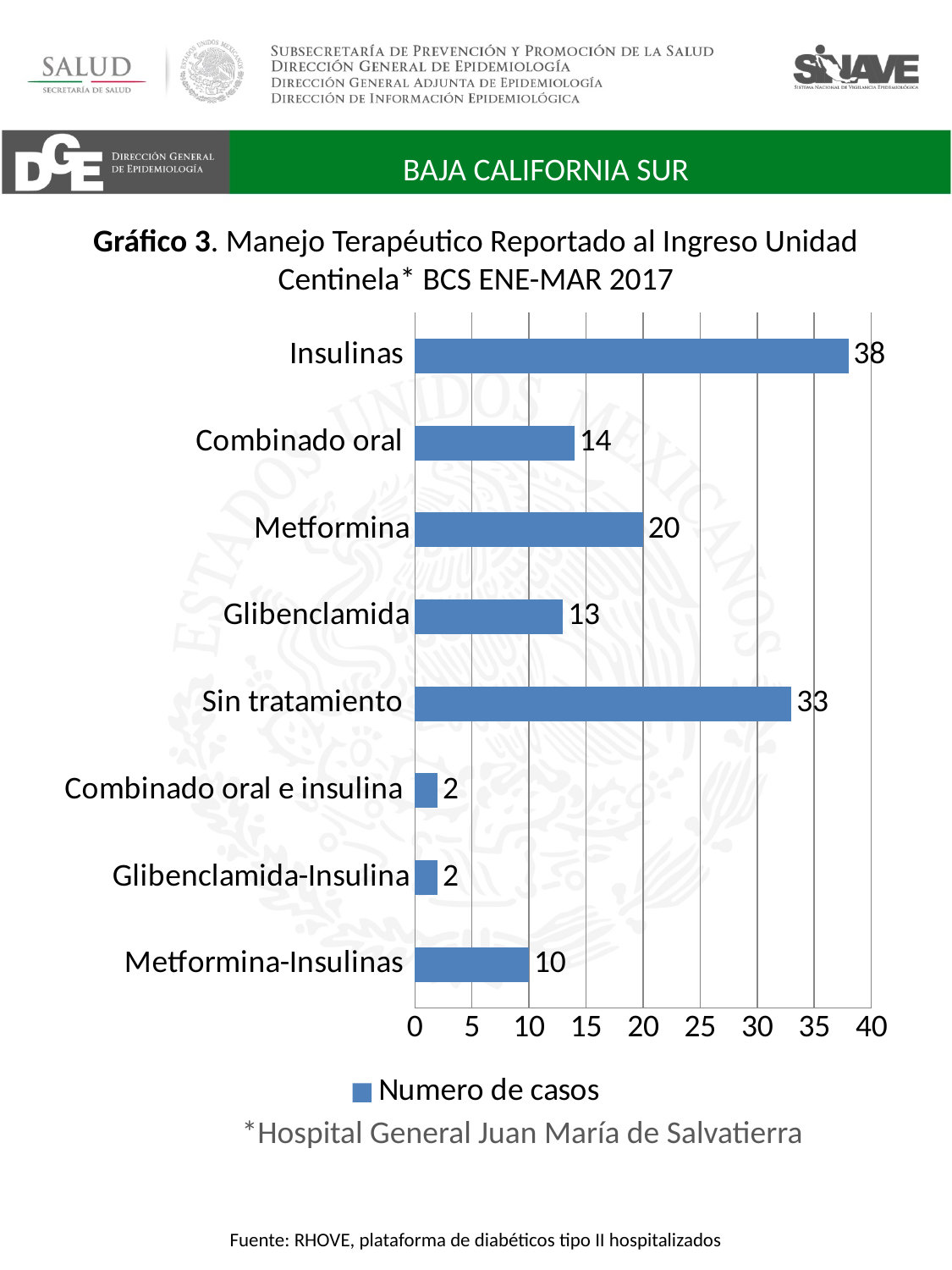
What is the number of cases for Glibenclamida? 13 Is the value for Sin tratamiento greater or less than 30? greater What is the difference in number of cases between Insulinas and Sin tratamiento? 5 What kind of chart is shown on the slide? Bar chart Which has more cases, Metformina or Combinado oral? Metformina What is the number of cases for Metformina-Insulinas? 10 How many categories are shown in the chart? 8 What is the difference in number of cases between Metformina and Combinado oral? 6 What is the number of cases for Sin tratamiento? 33 What series name does the legend show? Numero de casos Which category has the highest number of cases? Insulinas What is the number of cases for Insulinas? 38